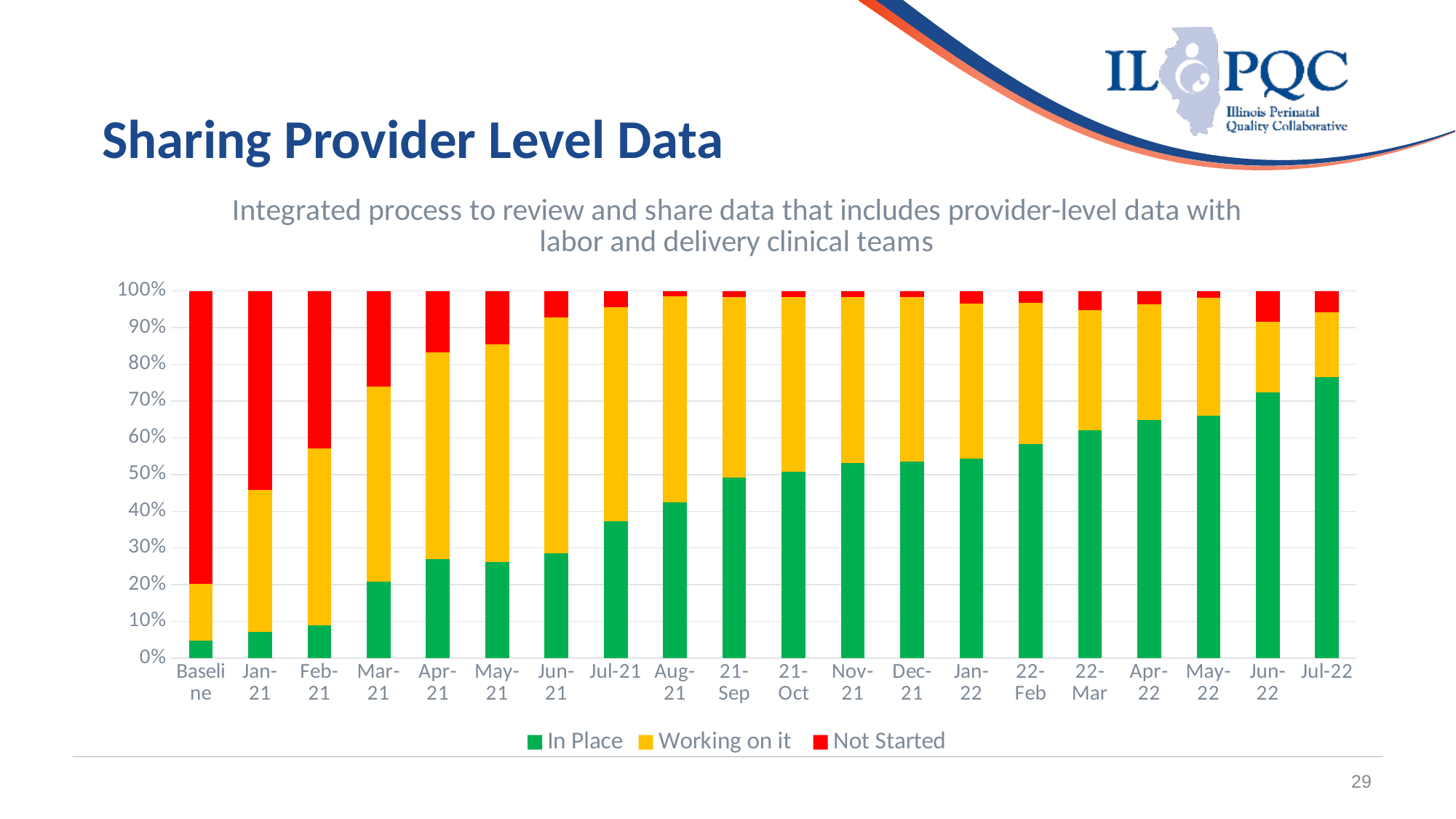
Does the In Place share rise or fall from Baseline to Jul-22? Rise How many series does the legend list? 3 What is the chart's title? Integrated process to review and share data that includes provider-level data with labor and delivery clinical teams Which has the larger Not Started share, Baseline or Jul-22? Baseline How many categories are shown along the x axis? 20 Is the In Place value for Baseline greater or less than 10%? less Which category has the highest In Place share? Jul-22 Is the Not Started value for Baseline greater or less than 70%? greater Is the In Place value for Jul-22 greater or less than 70%? greater What kind of chart is shown on the slide? Stacked bar chart Which series is shown in green in the legend? In Place Which category has the lowest In Place share? Baseline